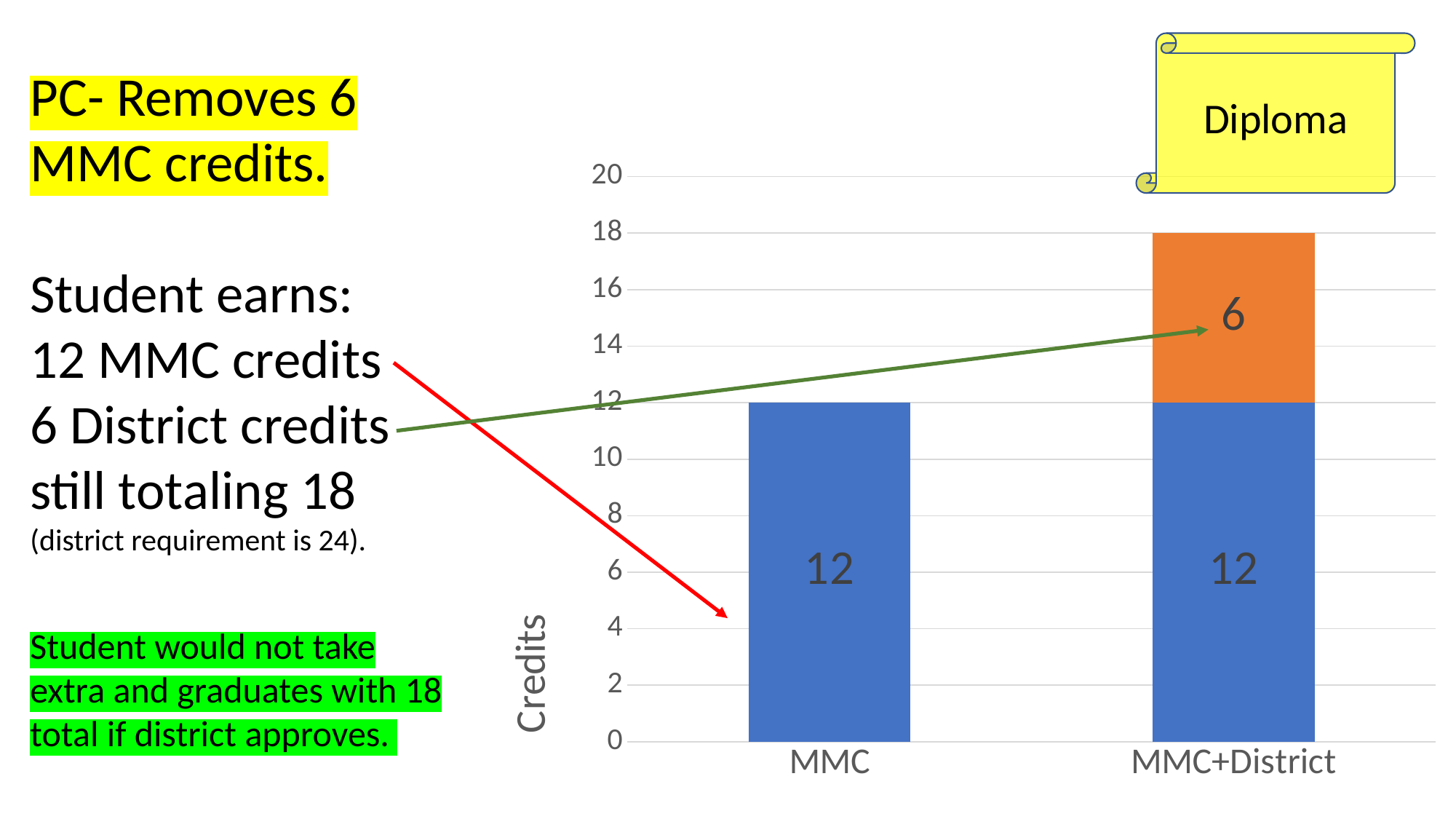
What is the label on the vertical axis? Credits Is the value for MMC greater or less than 14? less Which category has the taller bar, MMC or MMC+District? MMC+District How many categories are shown on the x axis? 2 What is the highest value shown on the vertical axis? 20 What is the difference between the total of the MMC+District bar and the MMC bar? 6 What is the value of the orange segment in the MMC+District bar? 6 What is the value of the blue segment in the MMC+District bar? 12 Is the total of the MMC+District bar greater or less than 16? greater What kind of chart is shown on the slide? bar chart What is the total of the MMC+District stacked bar? 18 What is the value of the blue segment for the MMC bar? 12